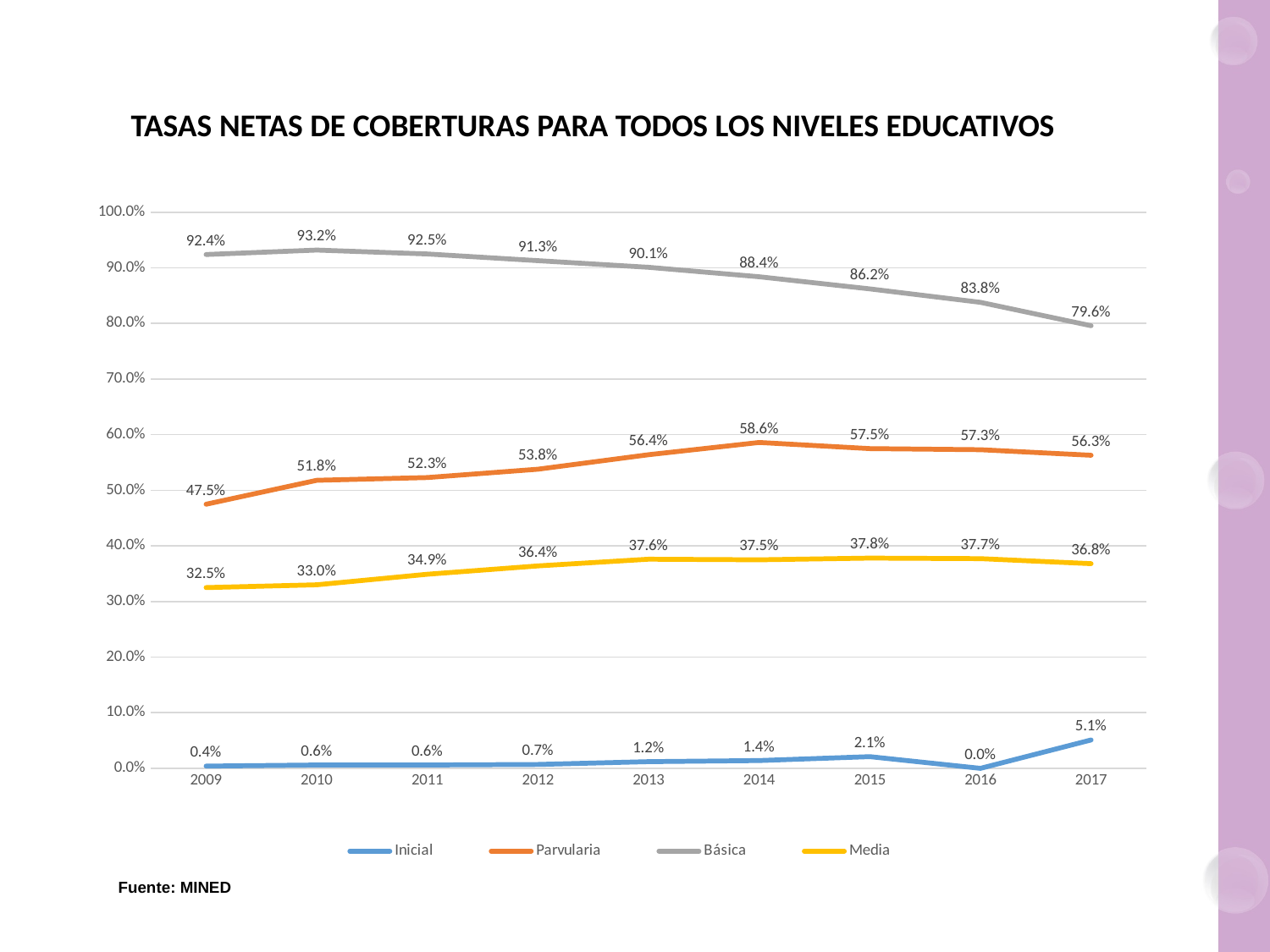
What is the value for Media in 2017? 36.8% How many series does the legend list? 4 Does the Básica series rise or fall from 2010 to 2017? Fall What kind of chart is this? Line chart In which year is the Básica series highest? 2010 Which is larger, the Media value in 2013 or the Media value in 2009? Media in 2013 What is the value for Básica in 2009? 92.4% What is the value for Parvularia in 2014? 58.6% In which year is the Parvularia series lowest? 2009 What is the value for Inicial in 2016? 0.0% What is the difference between the Básica values in 2009 and 2017? 12.8% How many years are shown on the x axis? 9